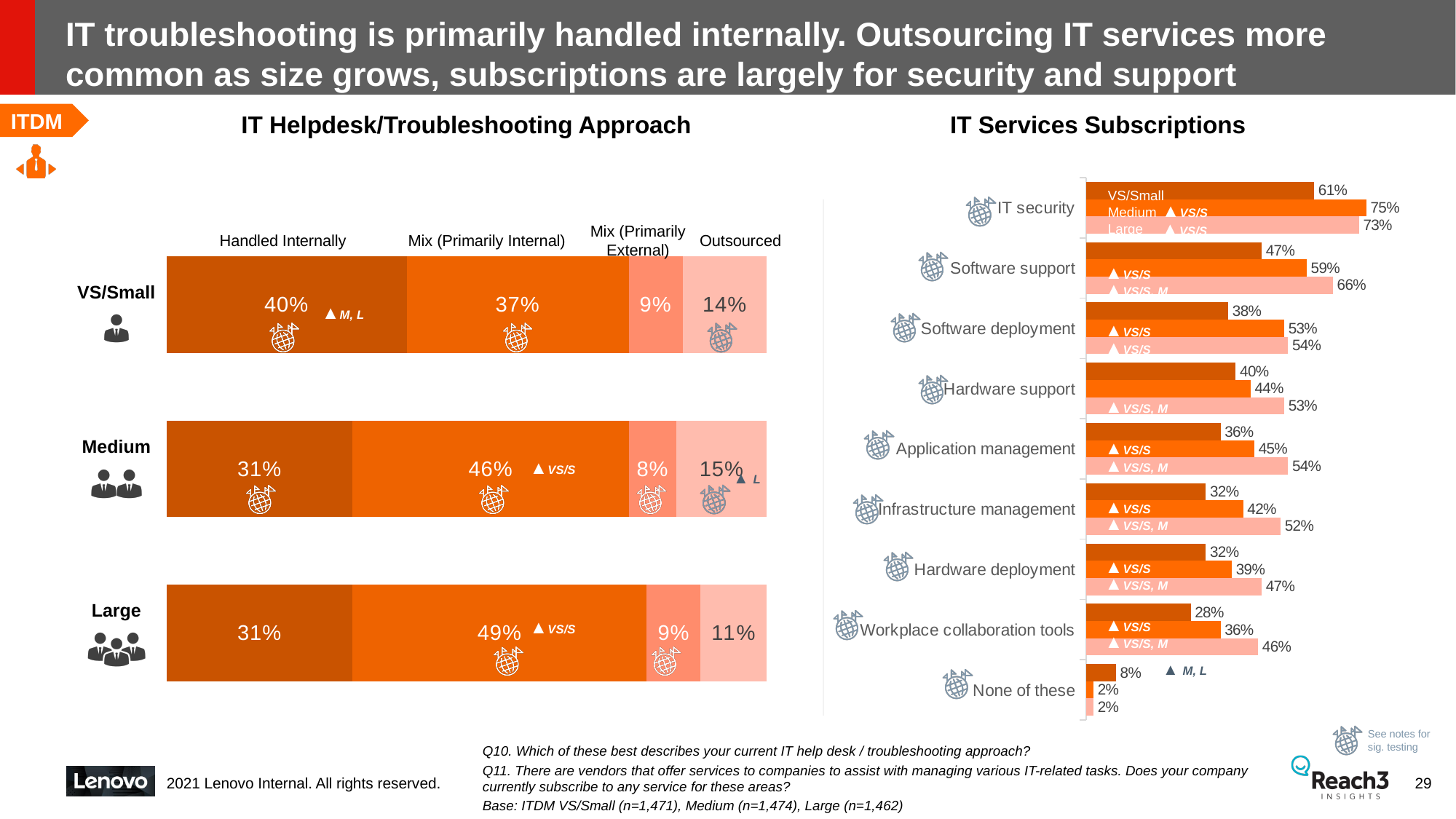
In the IT Services Subscriptions chart, which is larger for Hardware support: the VS/Small value or the Large value? Large What type of chart is the IT Services Subscriptions chart? Bar chart In the IT Services Subscriptions chart, which service has the highest VS/Small value? IT security In the IT Services Subscriptions chart, what is the Medium value for IT security? 75% In the IT Helpdesk/Troubleshooting Approach chart, what percentage of VS/Small companies handle IT internally? 40% In the IT Helpdesk/Troubleshooting Approach chart, what is the Mix (Primarily Internal) value for Large companies? 49% In the IT Helpdesk/Troubleshooting Approach chart, how many approach categories make up each stacked bar? 4 In the IT Services Subscriptions chart, what is the Large value for Software support? 66% In the IT Services Subscriptions chart, how many service categories are listed? 9 In the IT Helpdesk/Troubleshooting Approach chart, what is the difference between the Handled Internally values for VS/Small and Medium? 9 percentage points In the IT Helpdesk/Troubleshooting Approach chart, which company size has the highest Outsourced percentage? Medium In the IT Services Subscriptions chart, what is the difference between the Large and VS/Small values for Workplace collaboration tools? 18 percentage points